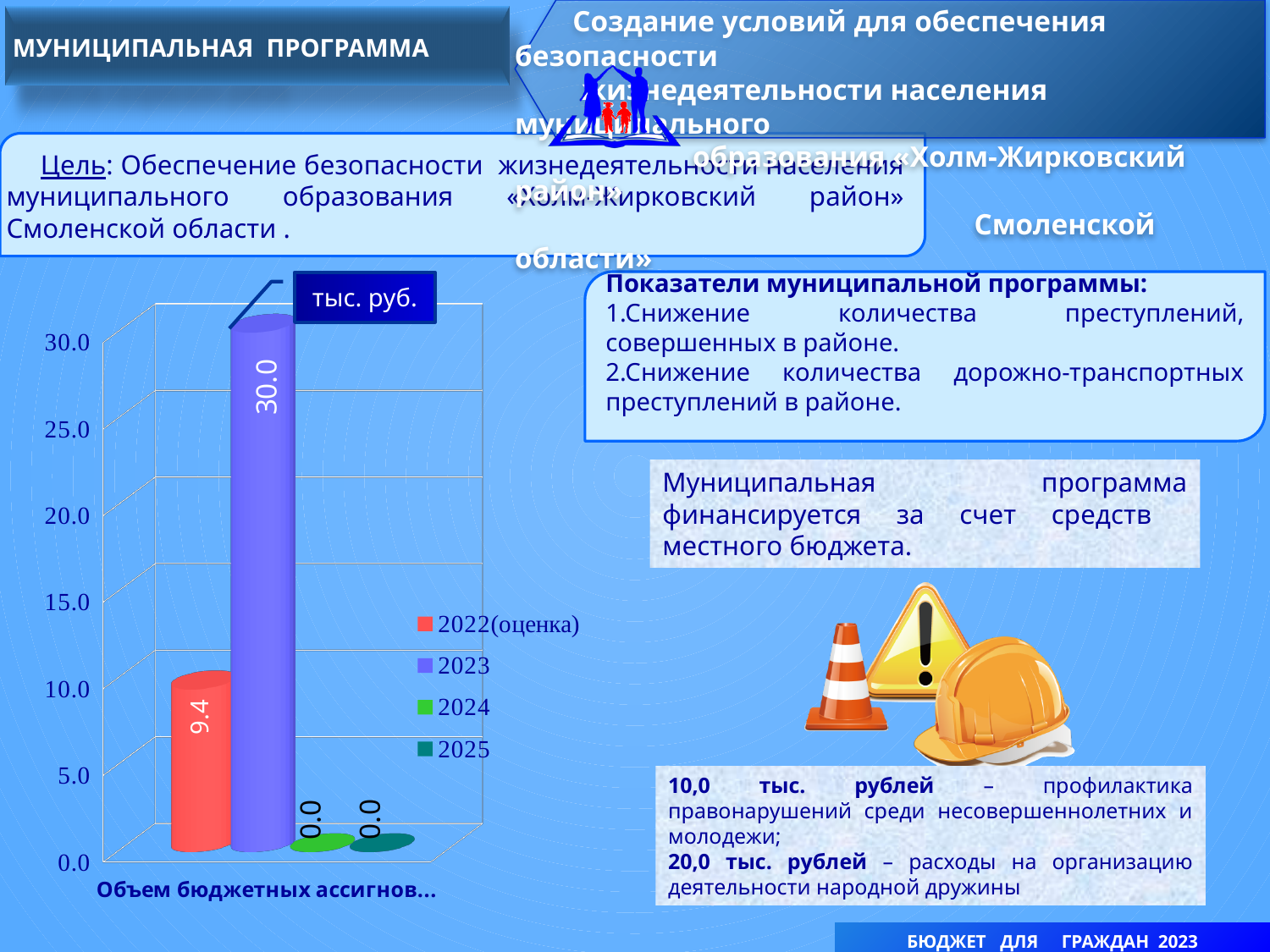
What is the difference between the values for 2023 and 2022(оценка)? 20.6 What is the highest value shown on the chart's vertical axis? 30.0 Is the value for 2022(оценка) greater or less than 10.0? less Which year has the highest value in the chart? 2023 Which is larger, the value for 2022(оценка) or the value for 2023? 2023 What unit is shown in the box above the chart? тыс. руб. How many series does the chart legend list? 4 What is the value for 2023 in the chart? 30.0 What type of chart is shown on the slide? bar chart What is the value for 2025 in the chart? 0.0 What is the value for 2022(оценка) in the chart? 9.4 What is the value for 2024 in the chart? 0.0